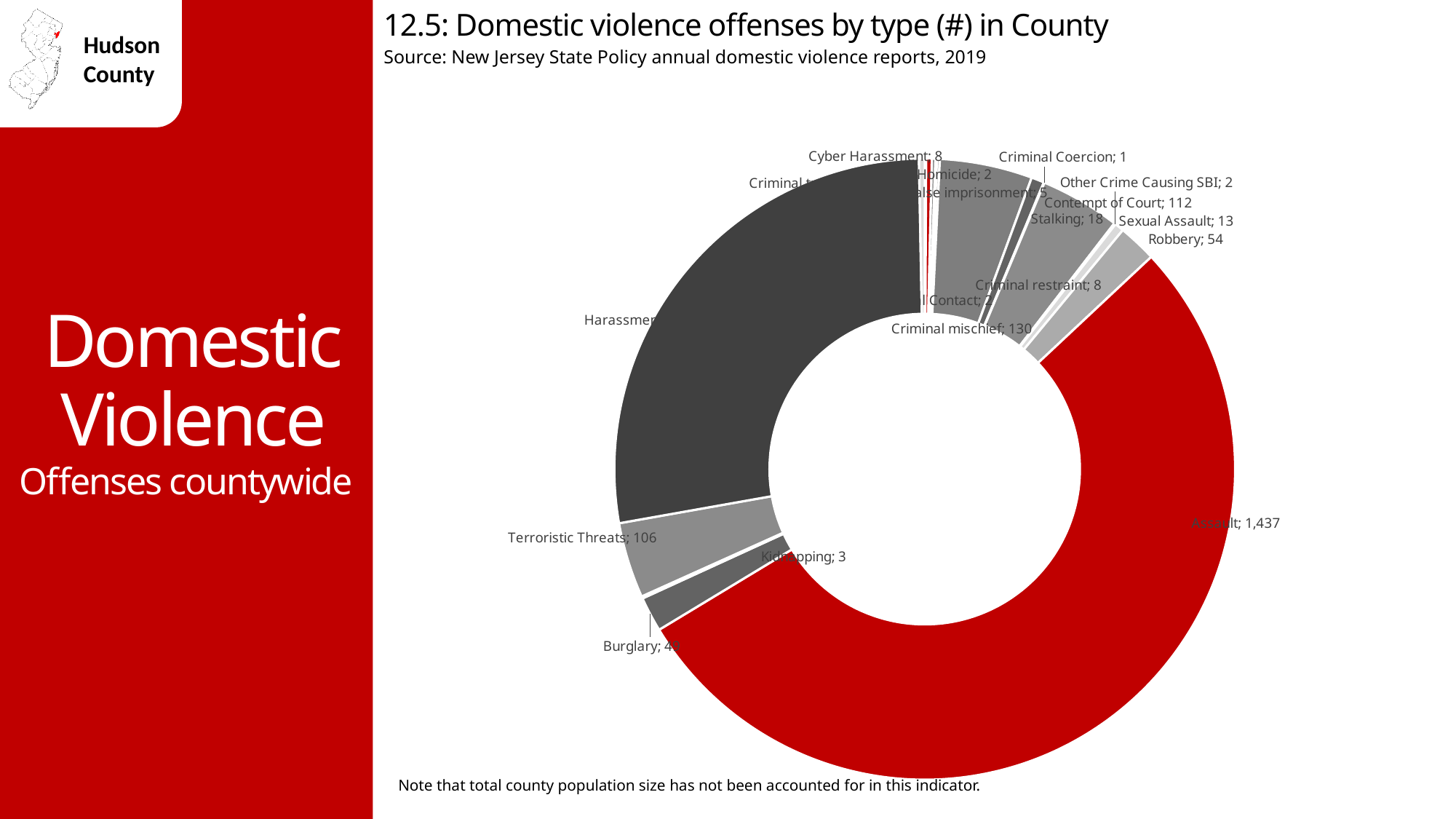
What value is shown for Contempt of Court? 112 Which offense type has the largest slice of the chart? Assault What is the difference between the Criminal mischief and Contempt of Court values? 18 What is the title of the chart? 12.5: Domestic violence offenses by type (#) in County What is the number of Assault offenses shown on the chart? 1,437 What is the value for Terroristic Threats? 106 What is the value shown for Kidnapping? 3 Which is larger, the value for Robbery or the value for Stalking? Robbery What is the value shown for Stalking? 18 What kind of chart is shown on the slide? Doughnut (pie) chart How many Robbery offenses are shown? 54 How many Criminal mischief offenses are shown on the chart? 130